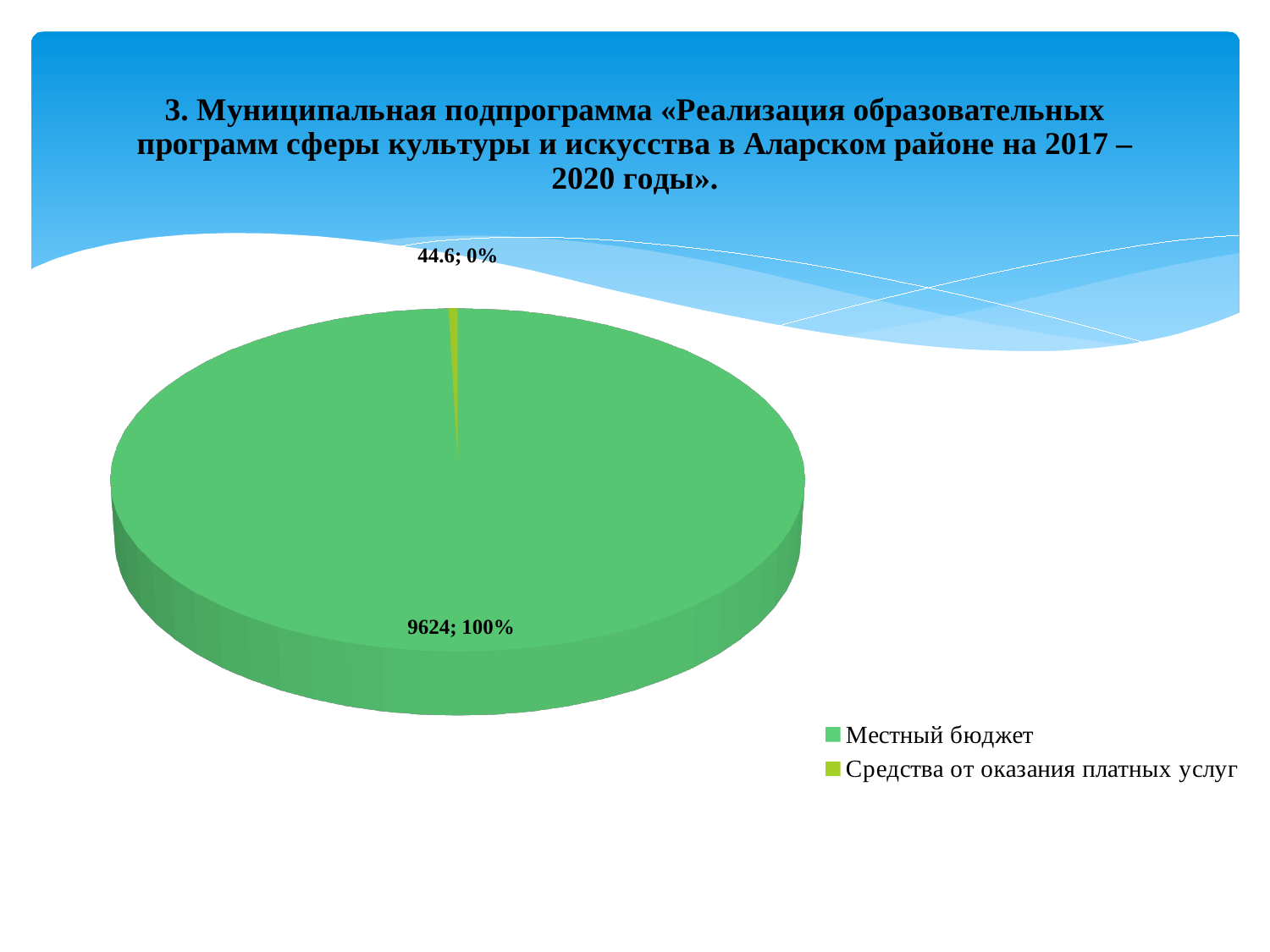
What share of the pie does Средства от оказания платных услуг account for, as labelled on the chart? 0% Which is larger: Местный бюджет or Средства от оказания платных услуг? Местный бюджет Which category has the smallest slice of the pie? Средства от оказания платных услуг How many entries does the legend list? 2 What colour is the slice for Местный бюджет? green What is the value shown for Местный бюджет? 9624 Which category has the largest slice of the pie? Местный бюджет What is the value shown for Средства от оказания платных услуг? 44.6 What share of the pie does Местный бюджет account for, as labelled on the chart? 100% What is the difference between the values for Местный бюджет and Средства от оказания платных услуг? 9579.4 What kind of chart is shown on the slide? pie chart How many slices does the pie chart have? 2